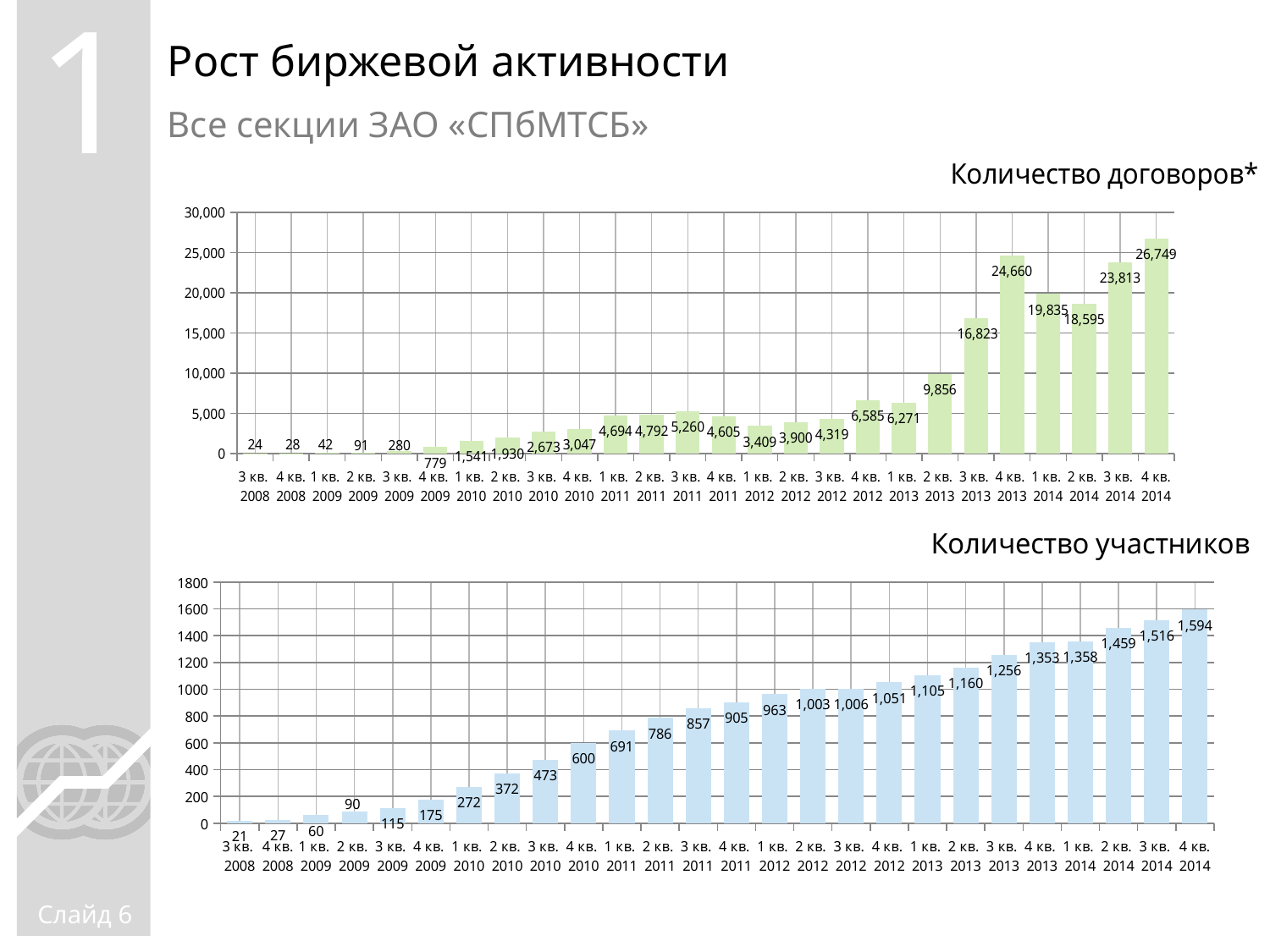
In the 'Количество договоров*' chart, what is the value for 2 кв. 2013? 9,856 How many quarters are plotted in the 'Количество участников' chart? 26 In the 'Количество договоров*' chart, what is the difference between 4 кв. 2013 and 1 кв. 2014? 4,825 In the 'Количество договоров*' chart, which quarter has the lowest value? 3 кв. 2008 What type of chart is the 'Количество участников' chart? Bar chart In the 'Количество участников' chart, what is the difference between 4 кв. 2014 and 3 кв. 2014? 78 In the 'Количество участников' chart, what is the value for 4 кв. 2014? 1,594 In the 'Количество договоров*' chart, which is larger: 3 кв. 2011 or 4 кв. 2011? 3 кв. 2011 In the 'Количество договоров*' chart, what is the value for 4 кв. 2014? 26,749 In the 'Количество участников' chart, do the values generally rise or fall from 3 кв. 2008 to 4 кв. 2014? Rise In the 'Количество участников' chart, what is the value for 1 кв. 2011? 691 In the 'Количество договоров*' chart, which quarter has the highest value? 4 кв. 2014